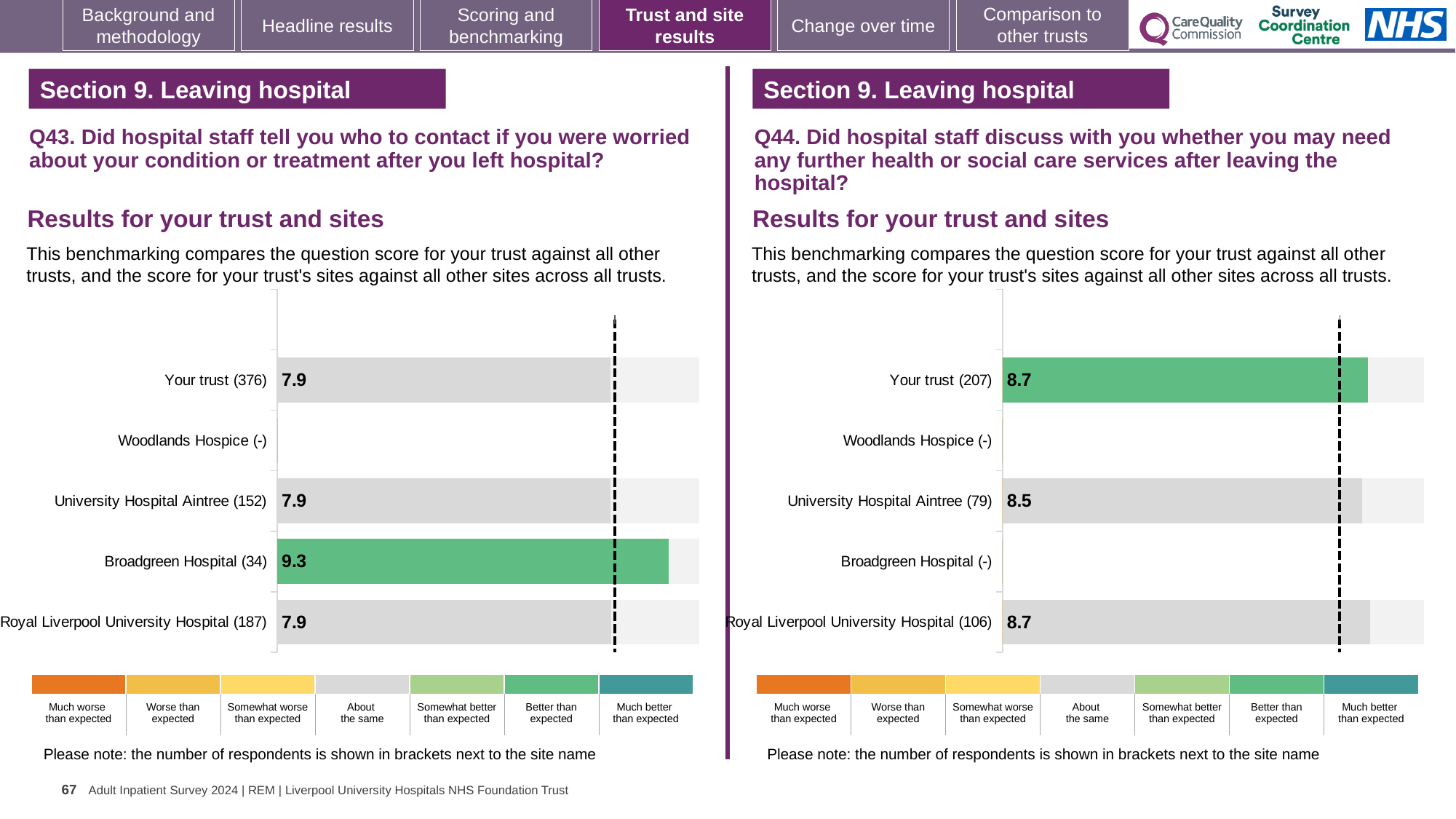
What type of chart is used for the Q44 results on the right? bar chart In the Q43 chart on the left, what is the score for Broadgreen Hospital? 9.3 In the Q44 chart on the right, which site with a score shown has the lowest score? University Hospital Aintree In the Q43 chart on the left, what is the difference between the score for Broadgreen Hospital and the score for University Hospital Aintree? 1.4 In the Q43 chart on the left, which site has the highest score? Broadgreen Hospital In the Q43 chart on the left, what is the score for Your trust? 7.9 In the Q43 chart on the left, how many respondents are shown for Royal Liverpool University Hospital? 187 In the Q44 chart on the right, what is the score for Royal Liverpool University Hospital? 8.7 In the Q44 chart on the right, what is the score for University Hospital Aintree? 8.5 In the Q44 chart on the right, is the score for Your trust larger or smaller than the score for University Hospital Aintree? larger How many site or trust rows are listed in the Q43 chart on the left? 5 In the Q44 chart on the right, what is the difference between the score for Your trust and the score for University Hospital Aintree? 0.2